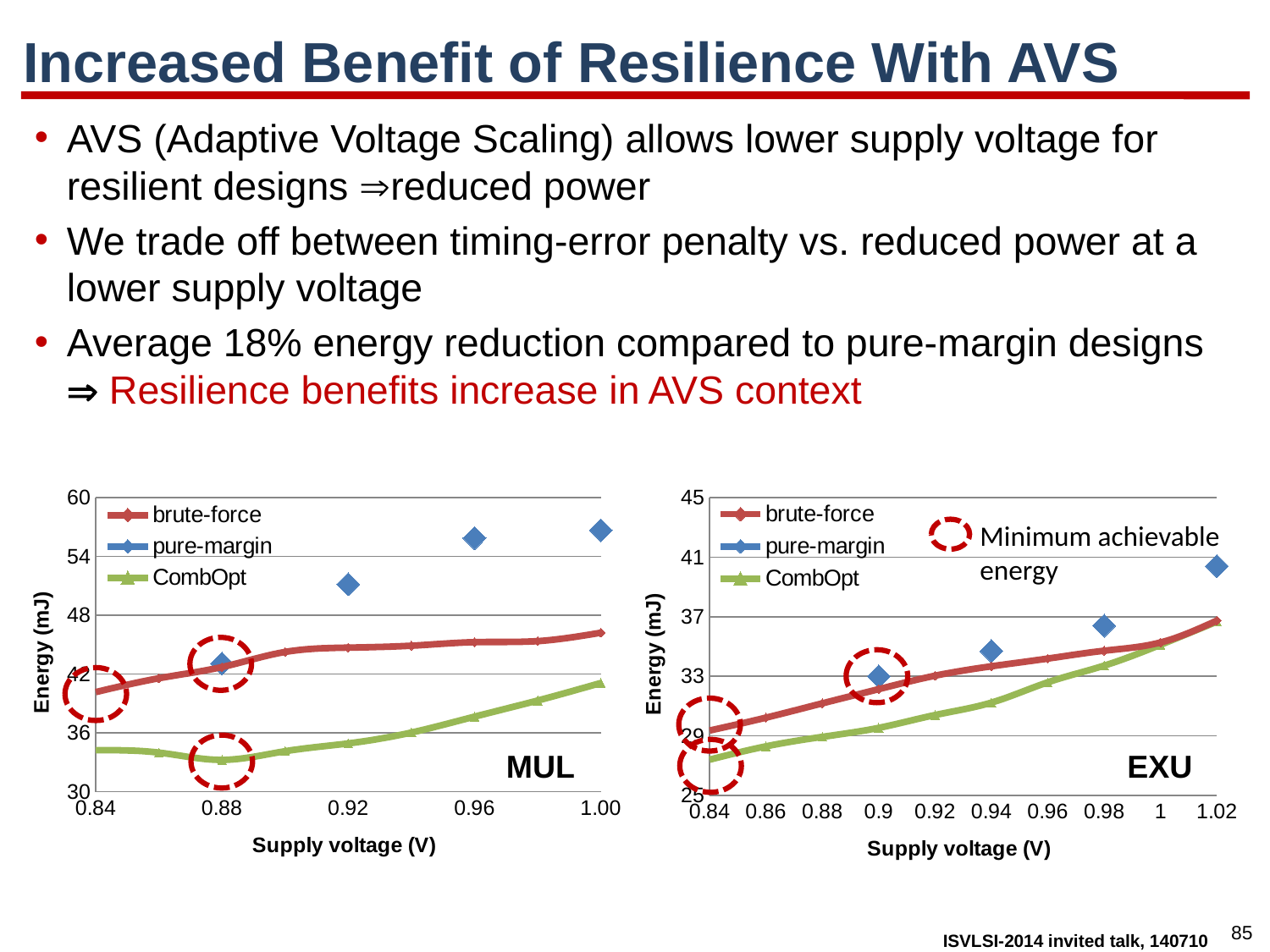
In the MUL chart, is the CombOpt value at 0.84 V greater or less than 36? less In the MUL chart, which is larger at 0.96 V: pure-margin or CombOpt? pure-margin In the MUL chart, is the pure-margin value at 1.00 V greater or less than 54? greater In the EXU chart, is the CombOpt value at 0.84 V greater or less than 29? less What is the x-axis label of the EXU chart? Supply voltage (V) In the EXU chart, which is larger at 0.98 V: pure-margin or CombOpt? pure-margin How many series does the legend of the EXU chart list? 3 In the MUL chart, does the brute-force series rise or fall as supply voltage increases from 0.84 V to 1.00 V? rise What kind of chart is the MUL chart on the left? line chart In the EXU chart, does the CombOpt series rise or fall as supply voltage increases from 0.84 V to 1.02 V? rise